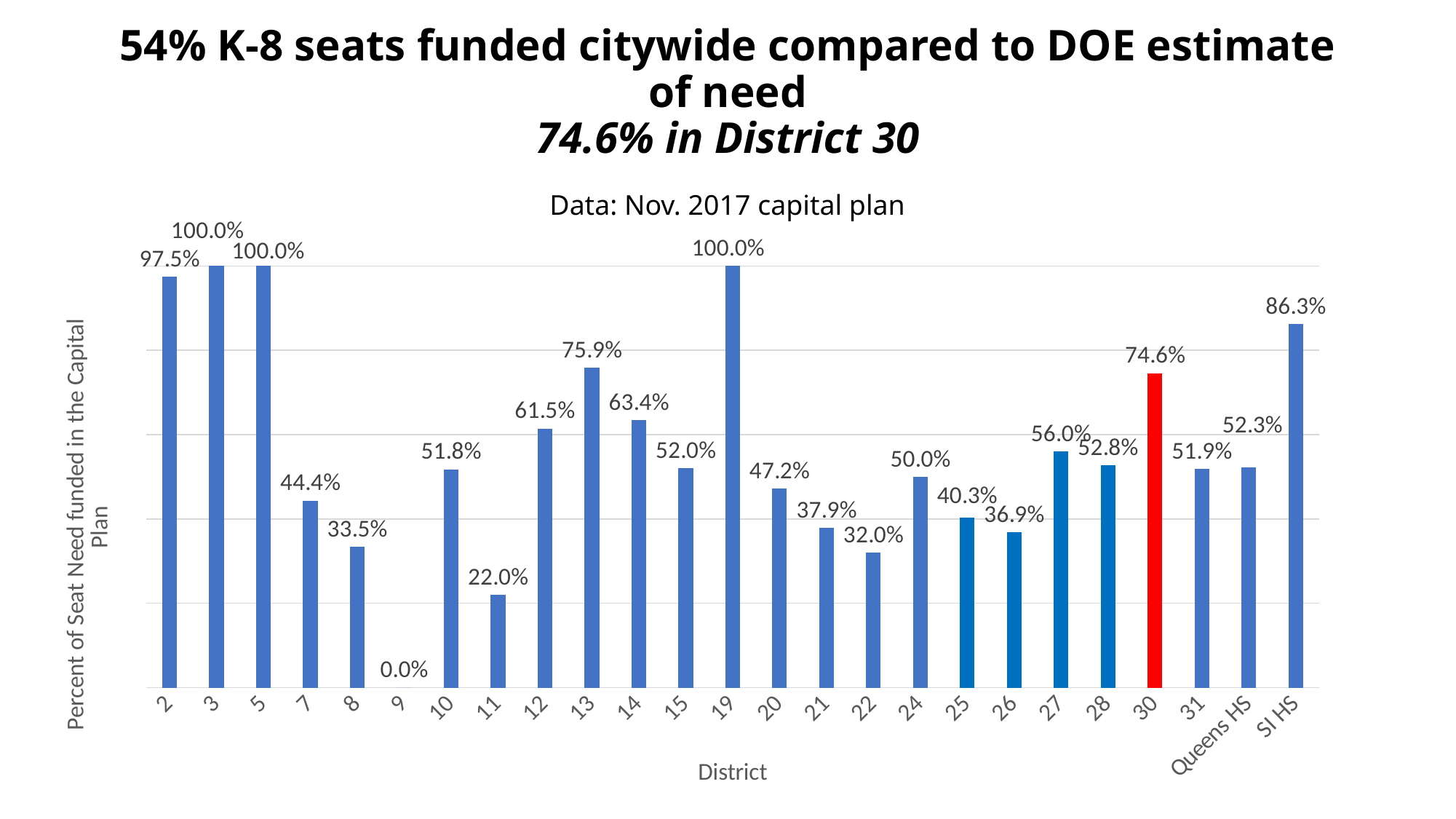
Which bar is highlighted in red? District 30 How many categories are shown on the x axis? 25 What is the value for District 11? 22.0% Which is larger, the value for District 14 or District 15? District 14 What is the value for SI HS? 86.3% Which district has the lowest value? 9 Which districts share the highest value of 100.0%? 3, 5 and 19 What is the value for Queens HS? 52.3% What is the difference between the values for District 30 and District 31? 22.7 percentage points What is the value for District 30? 74.6% What is the difference between the values for District 13 and District 12? 14.4 percentage points What kind of chart is shown? Bar chart